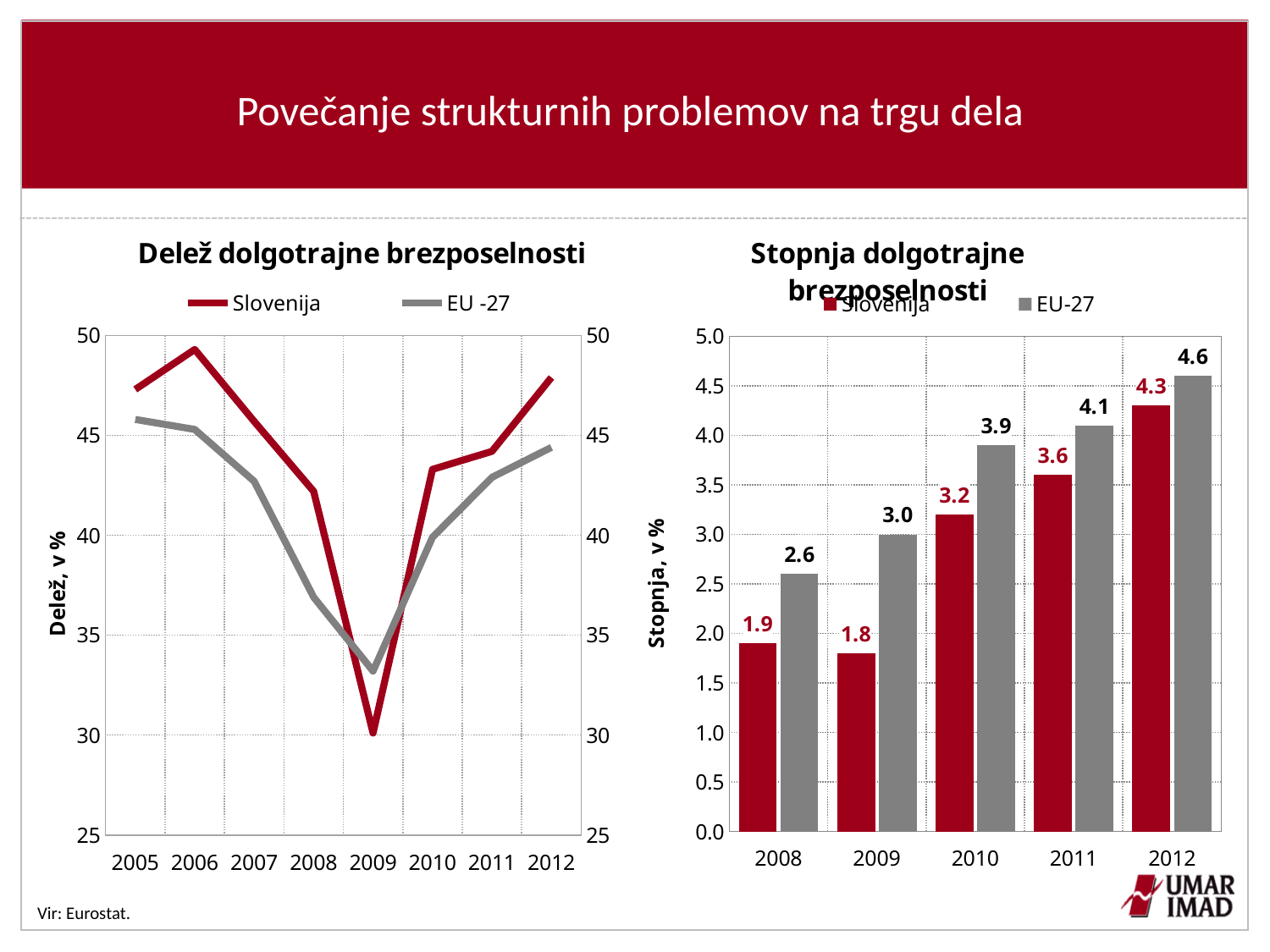
In the chart titled 'Stopnja dolgotrajne brezposelnosti', which year has the highest value for EU-27? 2012 In the chart titled 'Delež dolgotrajne brezposelnosti', is the value for EU -27 in 2008 greater or less than 40? less How many series does the legend of the chart titled 'Delež dolgotrajne brezposelnosti' list? 2 In the chart titled 'Stopnja dolgotrajne brezposelnosti', what is the difference between the EU-27 and Slovenija values in 2009? 1.2 In the chart titled 'Stopnja dolgotrajne brezposelnosti', which is larger in 2011: Slovenija or EU-27? EU-27 In the chart titled 'Stopnja dolgotrajne brezposelnosti', which year has the lowest value for Slovenija? 2009 What kind of chart is the one titled 'Delež dolgotrajne brezposelnosti'? line chart In the chart titled 'Stopnja dolgotrajne brezposelnosti', do the EU-27 values rise or fall from 2008 to 2012? rise In the chart titled 'Stopnja dolgotrajne brezposelnosti', how many years are shown on the x axis? 5 In the chart titled 'Stopnja dolgotrajne brezposelnosti', what is the value for EU-27 in 2008? 2.6 In the chart titled 'Delež dolgotrajne brezposelnosti', in which year does the Slovenija line reach its lowest point? 2009 In the chart titled 'Stopnja dolgotrajne brezposelnosti', what is the value for Slovenija in 2012? 4.3